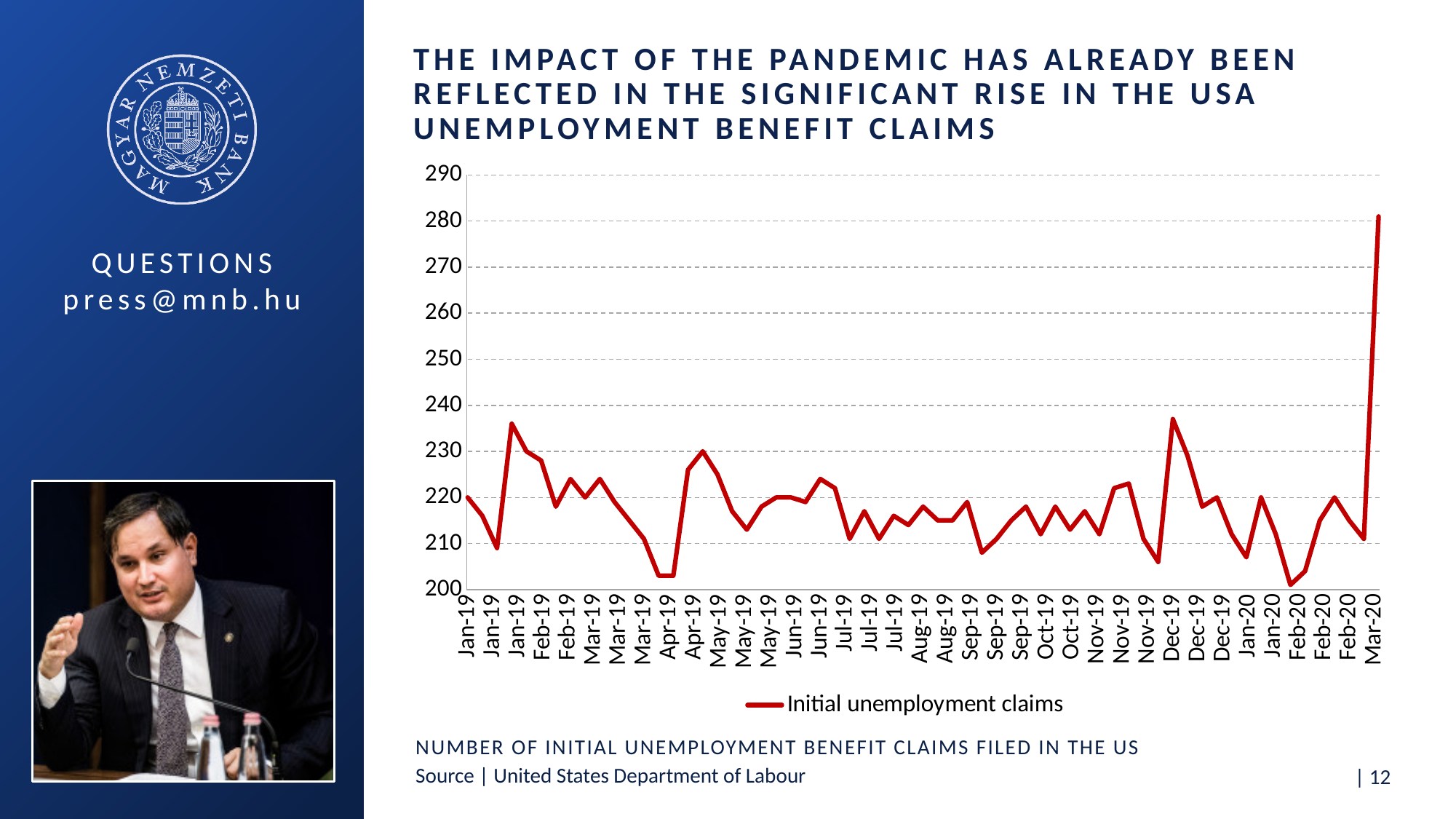
Is the lowest value in Feb-20 greater or less than 210? less Which point on the x axis has the highest value for initial unemployment claims? Mar-20 Is the value at the first Apr-19 point greater or less than 210? less Is the value at the peak in Dec-19 greater or less than 230? greater Does the line rise or fall between the last Feb-20 point and the final Mar-20 point? rise Which is larger, the value at the final Mar-20 point or the peak value in Dec-19? Mar-20 What is the name of the series shown in the legend? Initial unemployment claims What is the highest value shown on the y axis? 290 How many series does the legend list? 1 What kind of chart is shown on the slide? line chart